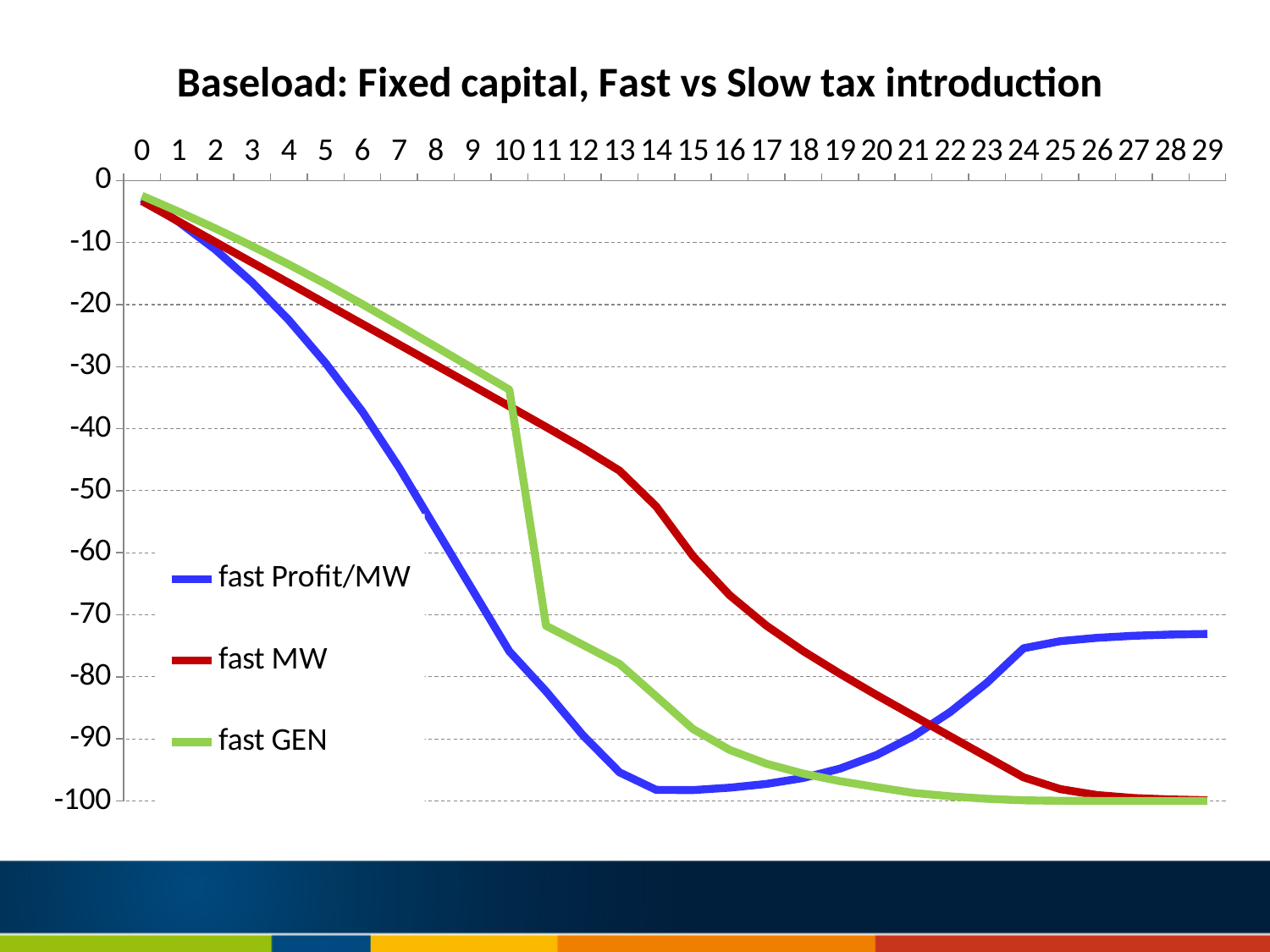
Is the value of fast Profit/MW at x = 14 greater or less than -90? less Does the fast MW series rise or fall as x increases from 0 to 29? fall Which colour is used for the fast GEN series? green How many series does the legend list? 3 At x = 20, which series has the higher value, fast Profit/MW or fast MW? fast MW Is the value of fast GEN at x = 11 greater or less than -70? less Does the fast Profit/MW series rise or fall between x = 14 and x = 29? rise Is the value of fast MW at x = 13 greater or less than -50? greater What is the title of the chart? Baseload: Fixed capital, Fast vs Slow tax introduction What kind of chart is shown on the slide? line chart How many x-axis positions (0 through 29) are shown on the chart? 30 Which series has the highest value at x = 29? fast Profit/MW